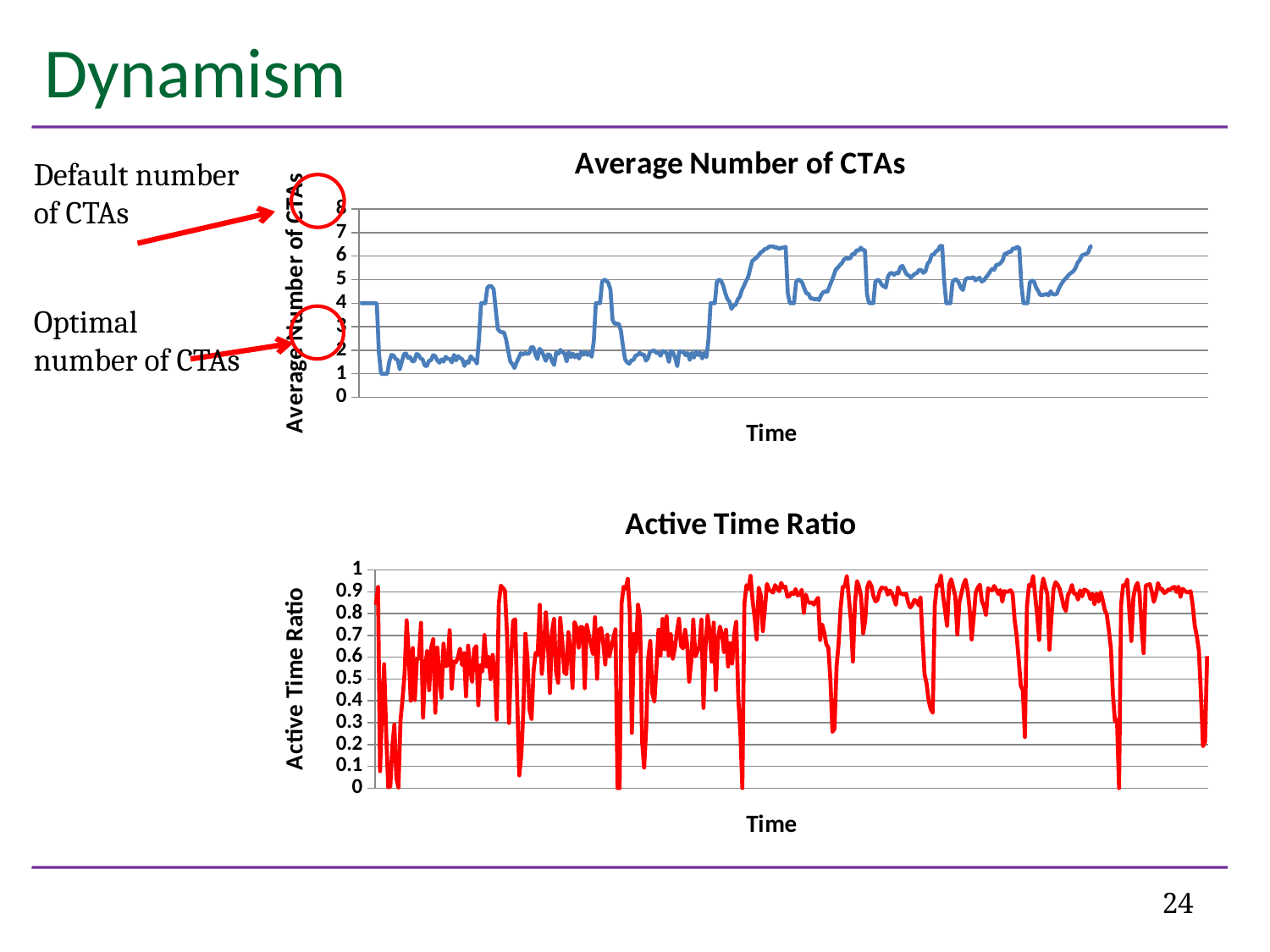
In the Average Number of CTAs chart, is the value at the end of the time axis higher or lower than the value at the start? higher In the Average Number of CTAs chart, is the value at the very start of the time axis greater or less than 3? greater What is the title of the top chart on the slide? Average Number of CTAs In the Average Number of CTAs chart, is the lowest value reached greater or less than 2? less What kind of chart is the Active Time Ratio chart? line chart In the Average Number of CTAs chart, do the values overall rise or fall along the time axis? rise What is the x-axis label of the Active Time Ratio chart? Time In the Active Time Ratio chart, is the highest value reached greater or less than 0.5? greater What kind of chart is the Average Number of CTAs chart? line chart In the Active Time Ratio chart, do the values overall rise or fall along the time axis? rise